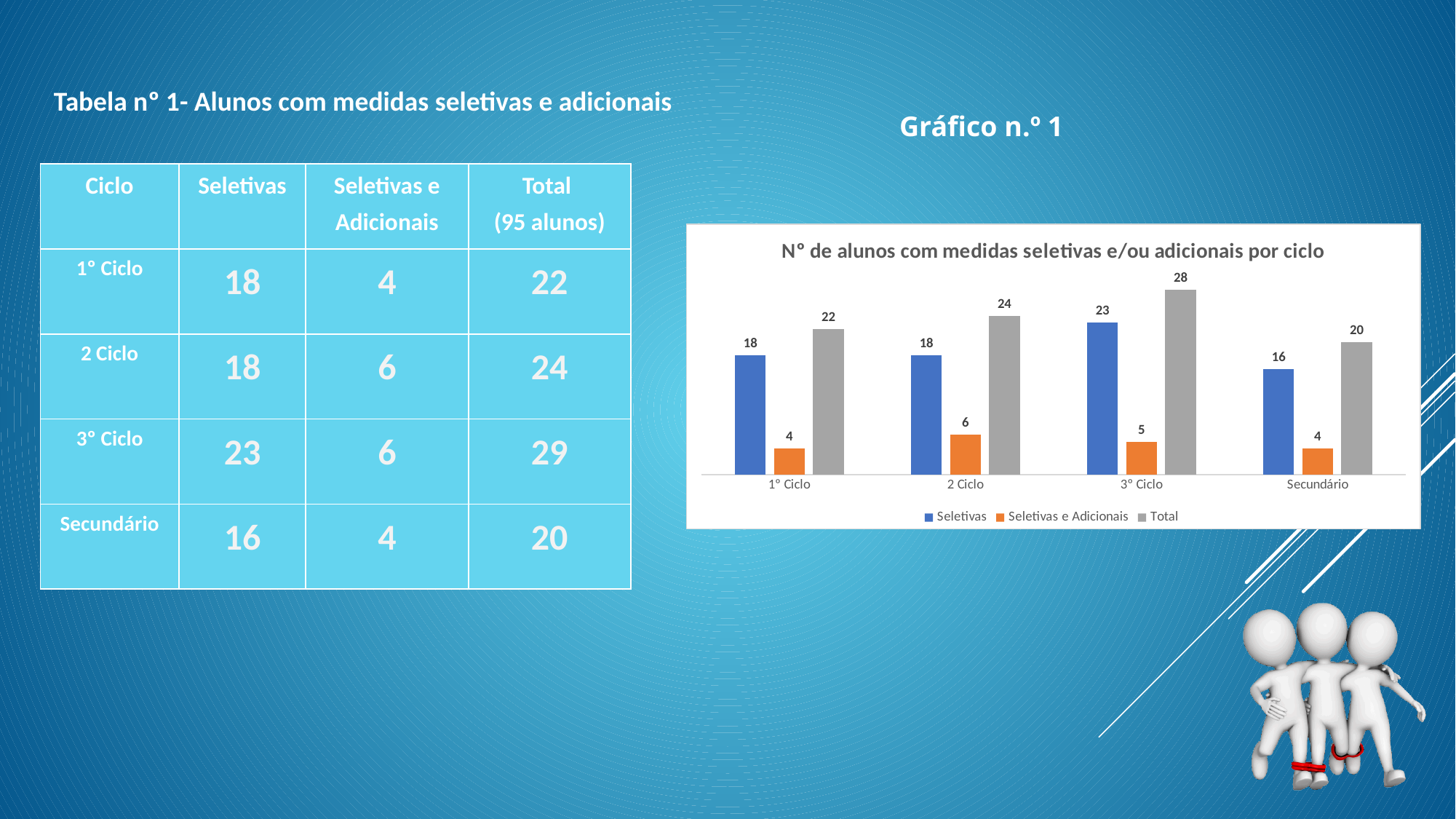
What is the difference between the Total values for 3° Ciclo and Secundário? 8 What is the value for Seletivas e Adicionais in 2 Ciclo? 6 What is the value for Seletivas in 3° Ciclo? 23 Which is larger, the Seletivas value for 1° Ciclo or the Seletivas value for Secundário? 1° Ciclo Which colour represents the Total series in the chart? grey What kind of chart is shown? bar chart What is the title of the chart? N° de alunos com medidas seletivas e/ou adicionais por ciclo Which category has the highest Total value? 3° Ciclo How many series does the legend list? 3 Which category has the lowest Seletivas value? Secundário What is the Total value for Secundário? 20 How many categories are shown on the x axis? 4